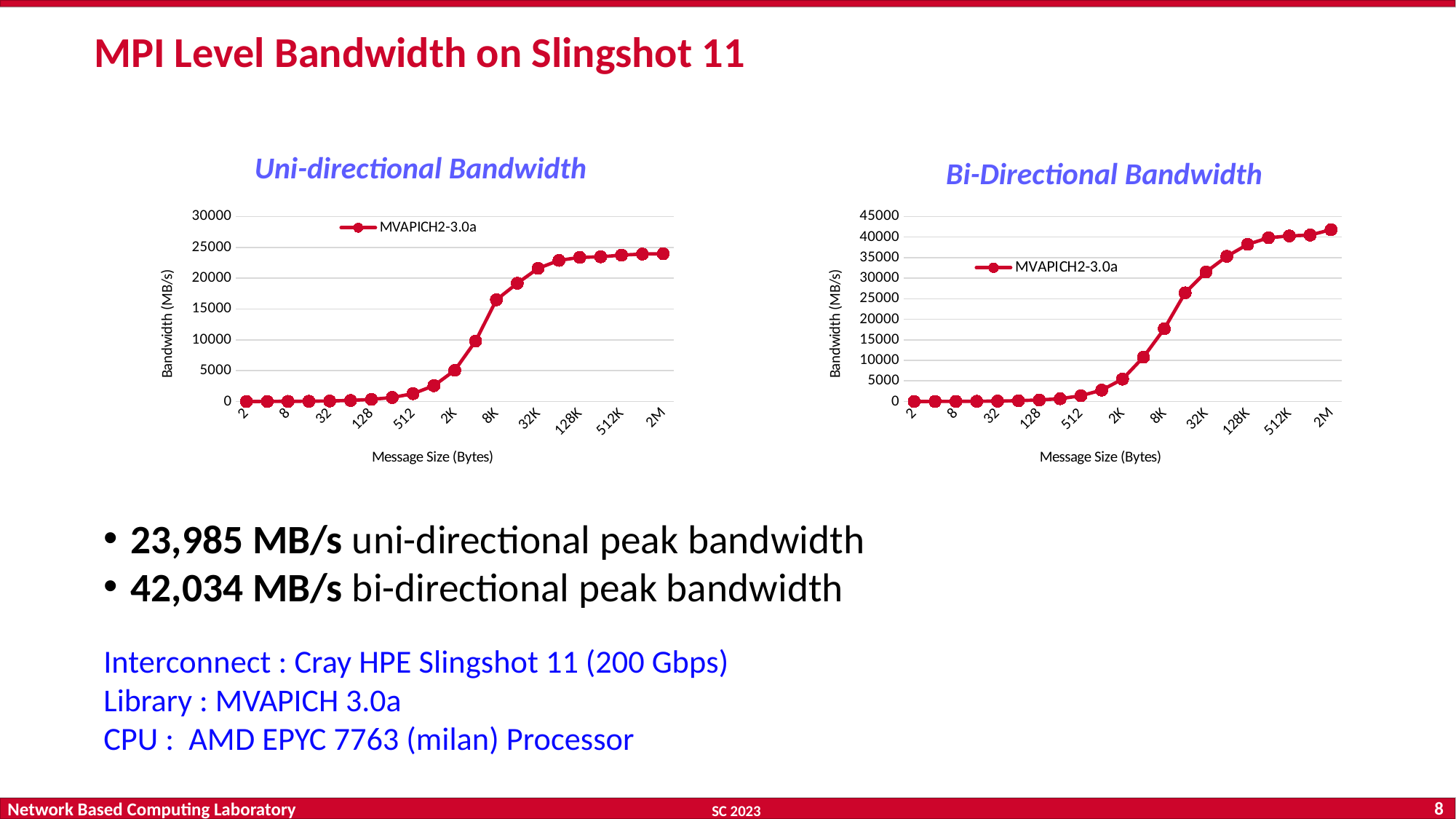
In the Bi-Directional Bandwidth chart, is the value for 8K greater or less than 15000? greater In the Uni-directional Bandwidth chart, is the value for 8K greater or less than 15000? greater In the Bi-Directional Bandwidth chart, at which message size is the bandwidth highest? 2M In the Uni-directional Bandwidth chart, how many series does the legend list? 1 What type of chart is the Uni-directional Bandwidth chart? line chart In the Uni-directional Bandwidth chart, is the value for 512 greater or less than 5000? less In the Uni-directional Bandwidth chart, at which message size is the bandwidth lowest? 2 In the Bi-Directional Bandwidth chart, what is the label of the y axis? Bandwidth (MB/s) In the Bi-Directional Bandwidth chart, what series name is shown in the legend? MVAPICH2-3.0a What type of chart is the Bi-Directional Bandwidth chart? line chart In the Uni-directional Bandwidth chart, does bandwidth rise or fall as message size increases along the x axis? rise